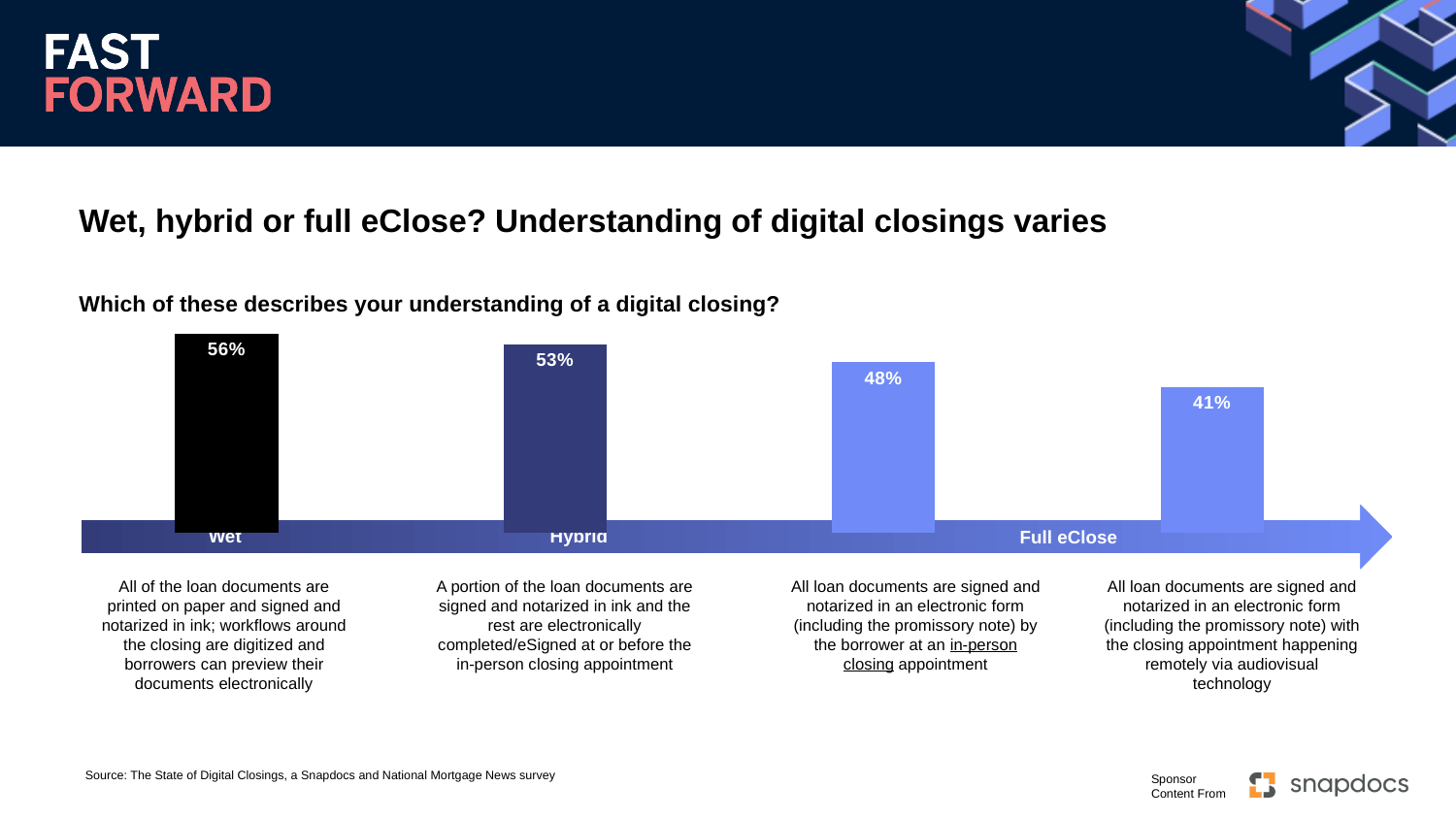
Which bar has the highest value? Wet What value is shown for the Hybrid bar? 53% Do the bar values rise or fall from left to right across the chart? Fall Which is larger, the Hybrid bar or the third bar from the left (48%)? Hybrid What kind of chart is shown on the slide? Bar chart What value is shown for the rightmost bar (full eClose with the closing appointment happening remotely via audiovisual technology)? 41% Which bar has the lowest value? The rightmost bar (full eClose with remote audiovisual closing), 41% What is the difference between the Wet bar and the Hybrid bar? 3 percentage points What value is shown for the Wet bar? 56% How many bars are plotted in the chart? 4 What is the difference between the Wet bar (56%) and the rightmost bar (41%)? 15 percentage points What value is shown for the third bar from the left (full eClose with an in-person closing appointment)? 48%